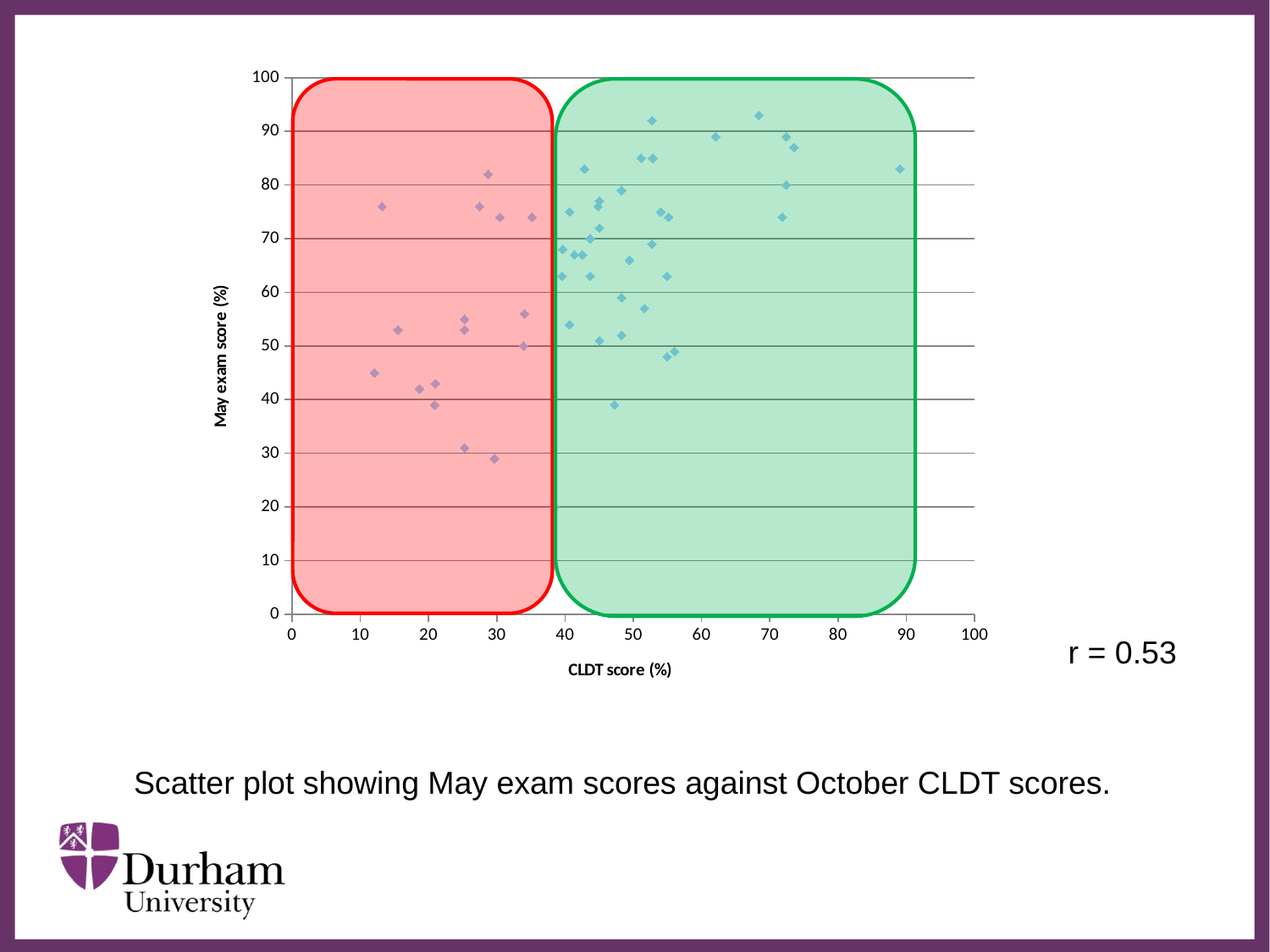
What correlation coefficient (r) is printed next to the scatter plot? r = 0.53 Is the lowest May exam score plotted greater or less than 40? less Is the highest CLDT score plotted greater or less than 80? greater Is the highest May exam score plotted greater or less than 90? greater What kind of chart is shown on the slide? Scatter plot What is the label of the x axis of the scatter plot? CLDT score (%) What is the maximum value shown on the y axis of the scatter plot? 100 As CLDT score increases along the x axis, do May exam scores generally rise or fall? rise